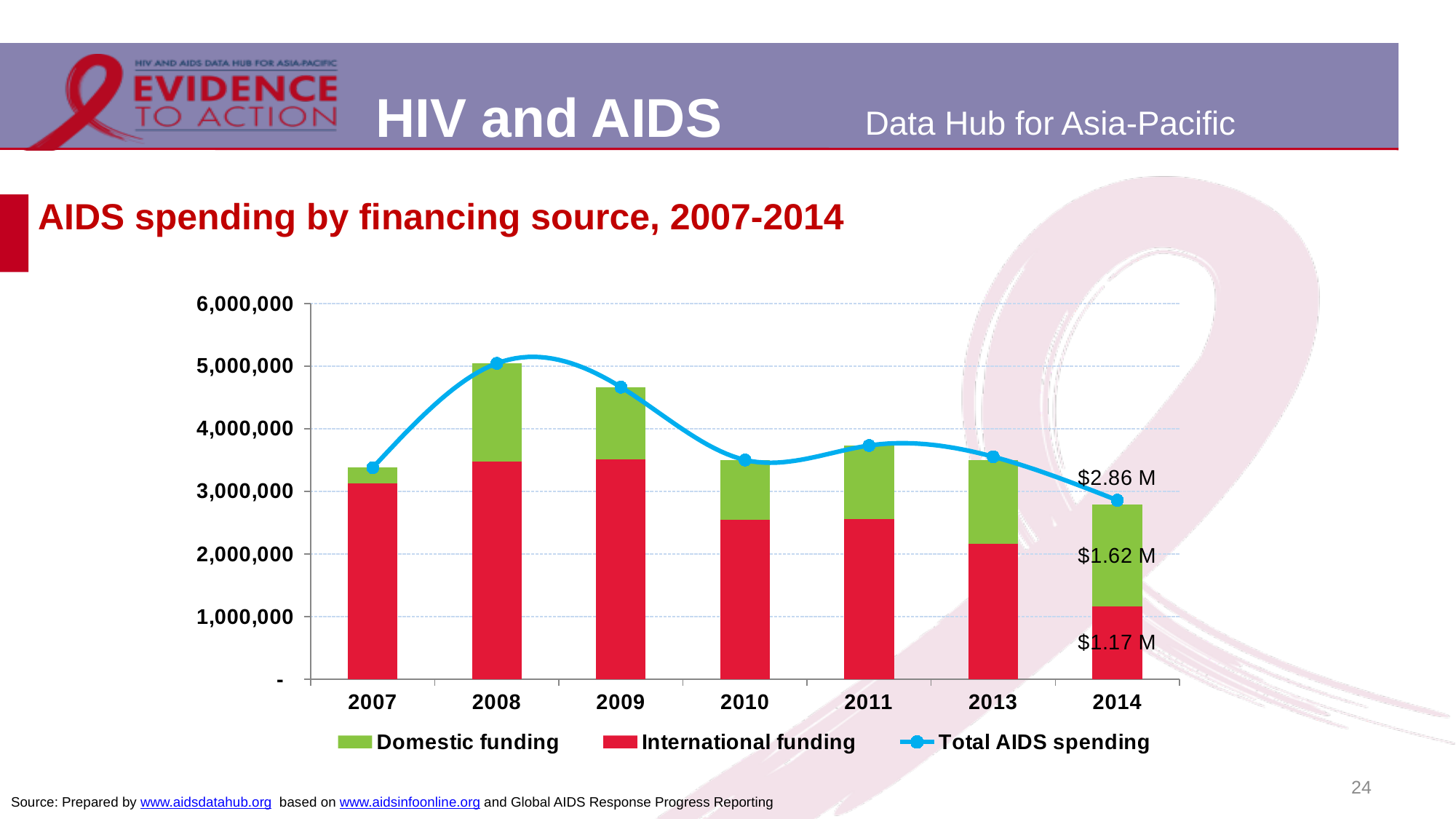
What kind of chart is used to show the funding sources? Stacked bar chart with a line What is the international funding value labelled for 2014? $1.17 M Which year had higher international funding, 2009 or 2010? 2009 Is the international funding for 2008 greater or less than 3,000,000? greater In 2014, how much larger is domestic funding than international funding? $0.45 M How many years are shown on the x axis? 7 In which year was total AIDS spending lowest? 2014 Is the total AIDS spending for 2010 greater or less than 4,000,000? less How many series does the legend list? 3 What is the total AIDS spending shown for 2014? $2.86 M In which year was total AIDS spending highest? 2008 What is the domestic funding value labelled for 2014? $1.62 M